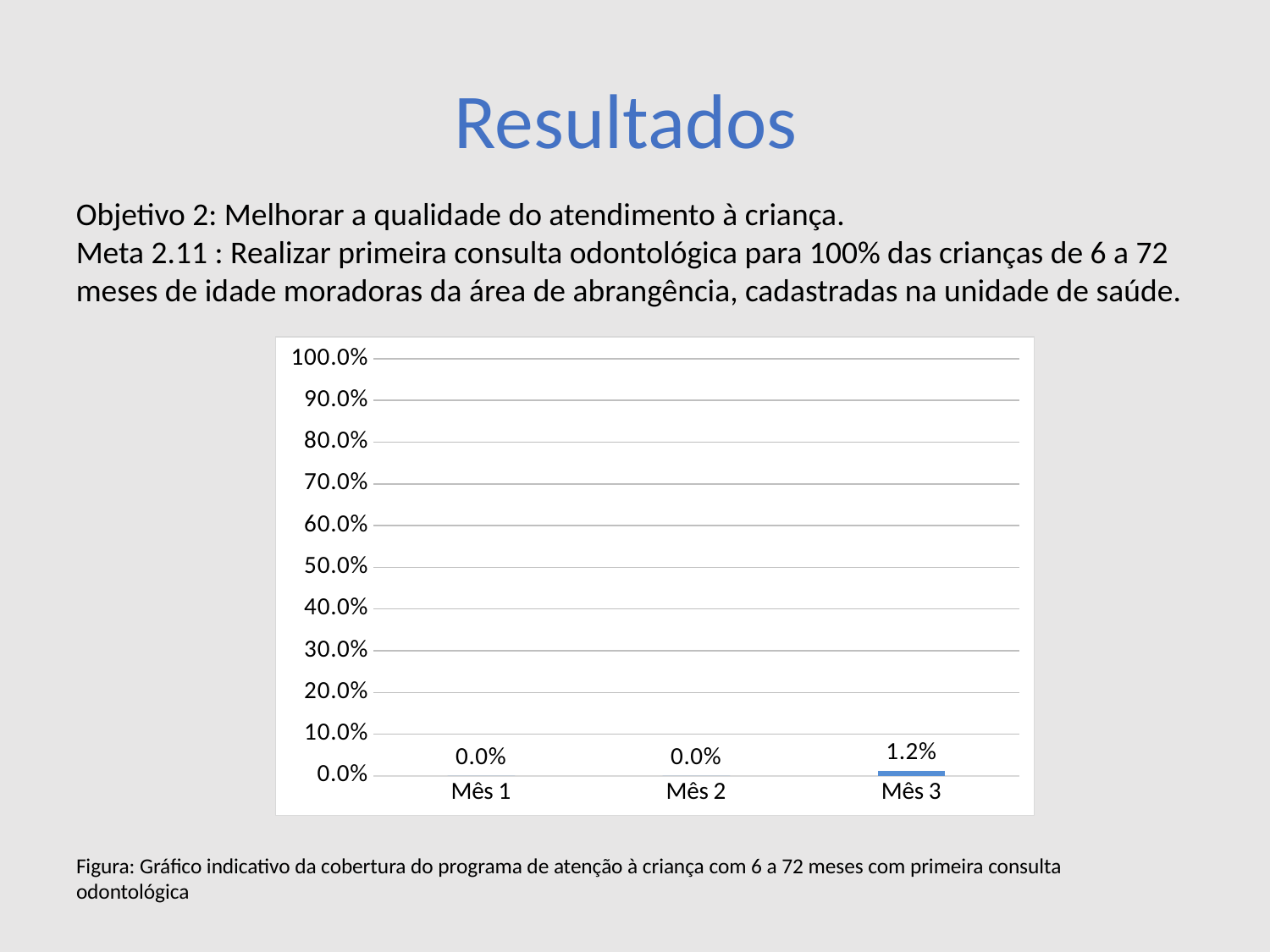
What is the highest value shown on the y axis? 100.0% What colour is the bar for Mês 3? blue Is the value for Mês 3 greater or less than 10.0%? less Which is larger, the value for Mês 2 or the value for Mês 3? Mês 3 Which month has the highest value? Mês 3 What is the value for Mês 1? 0.0% What is the value for Mês 2? 0.0% Do the values rise or fall from Mês 1 to Mês 3? rise How many categories are shown on the x axis? 3 What is the value for Mês 3? 1.2% What is the difference between the values for Mês 3 and Mês 1? 1.2% What kind of chart is shown on the slide? bar chart